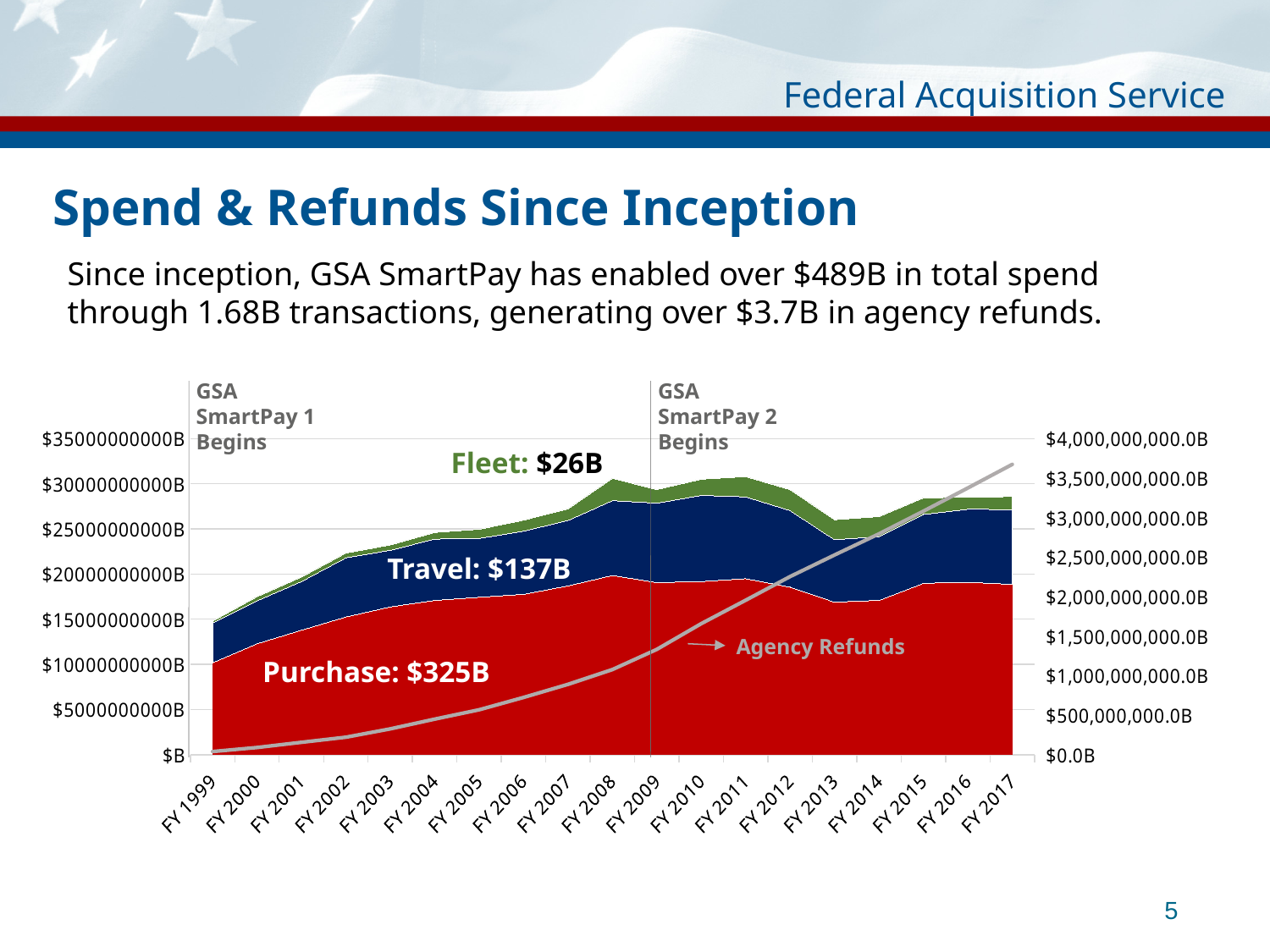
What is the difference between the labeled Purchase total and the labeled Travel total? $188B Which labeled total is larger, Travel or Fleet? Travel What kind of chart is shown on the slide? Stacked area chart with a line Does the Agency Refunds line rise or fall from FY 1999 to FY 2017? Rises Which of the three spend categories has the largest labeled total? Purchase How many fiscal years are shown on the x axis? 19 Which of the three spend categories has the smallest labeled total? Fleet In which fiscal year does the chart mark that GSA SmartPay 2 begins? FY 2009 What total spend value is labeled for the Fleet area? $26B What total spend value is labeled for the Purchase area? $325B Is the Agency Refunds value for FY 2017 greater or less than $3,500,000,000.0B? greater What total spend value is labeled for the Travel area? $137B